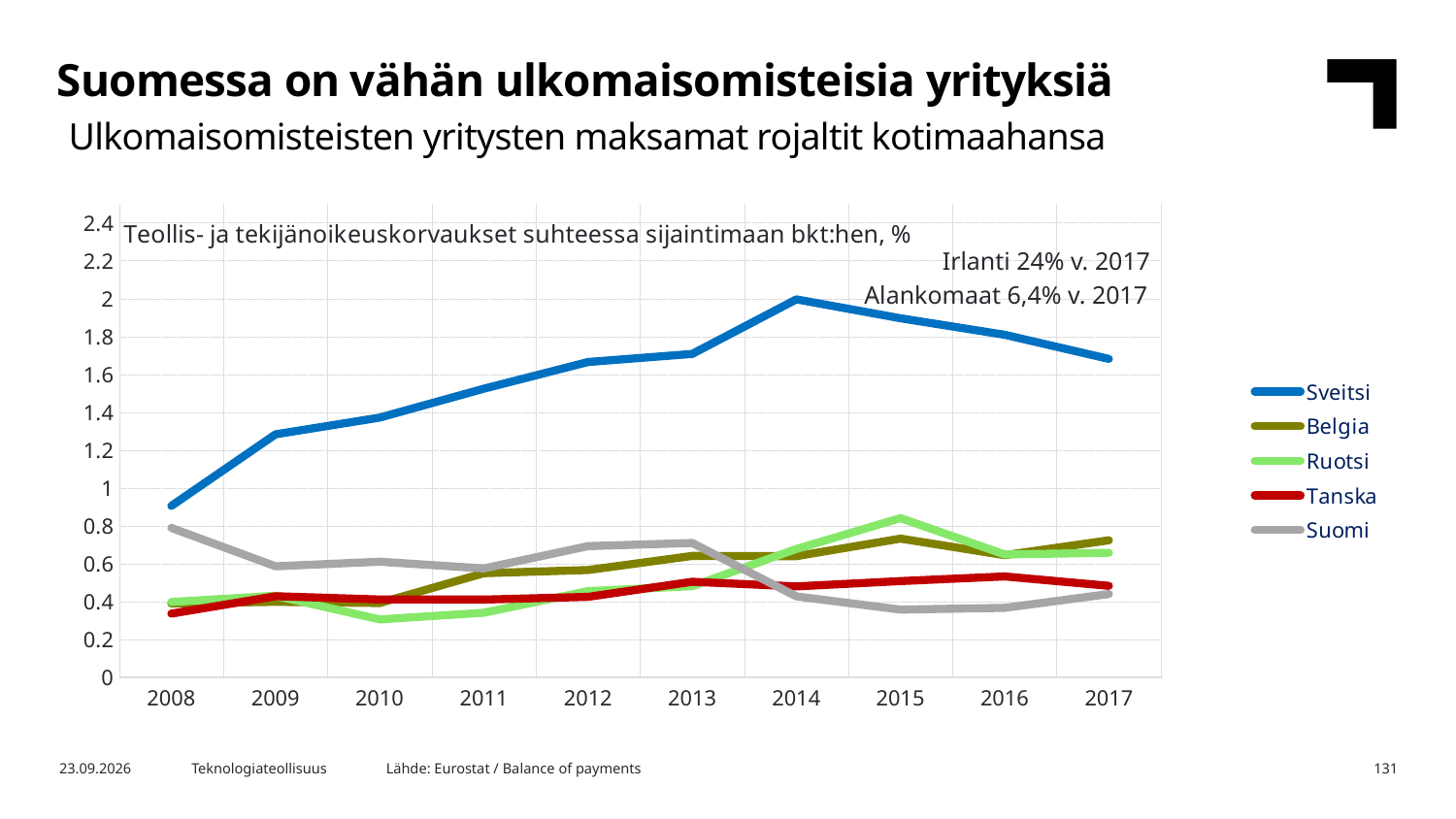
Which country has the highest value in 2017? Sveitsi What type of chart is shown on the slide? line chart Is the value for Suomi in 2008 greater or less than 0.6? greater How many years are shown on the x axis? 10 Is the value for Ruotsi in 2015 greater or less than 0.6? greater Which is larger in 2017, the value for Sveitsi or the value for Suomi? Sveitsi How many series does the legend list? 5 Does the Sveitsi line rise or fall from 2008 to 2014? rise Is the value for Sveitsi in 2008 greater or less than 1? less According to the annotation on the chart, what was the value for Irlanti in 2017? 24% Which country has the lowest value in 2015? Suomi